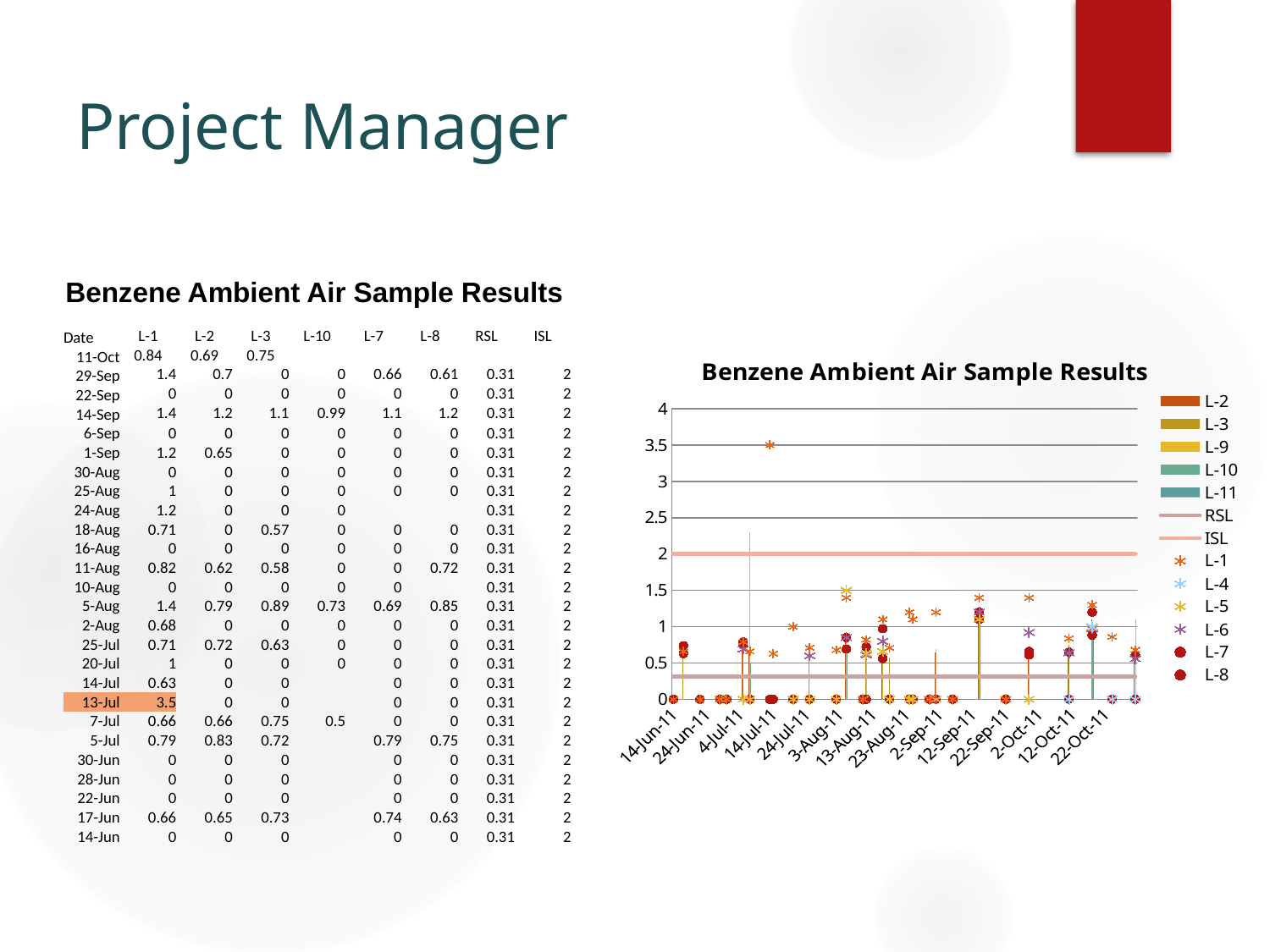
How many series does the chart's legend list? 13 What is the first date label shown on the chart's horizontal axis? 14-Jun-11 Is the highest L-1 point on the chart greater or less than 3? greater What is the title of the chart on the right side of the slide? Benzene Ambient Air Sample Results What is the highest value shown on the chart's vertical axis? 4 At what value does the ISL line sit on the chart? 2 Which is higher on the chart, the ISL line or the RSL line? ISL Which series has the single highest plotted point on the chart? L-1 What is the last date label shown on the chart's horizontal axis? 22-Oct-11 Is the RSL line on the chart greater or less than 0.5? less What value does the highest plotted point for L-1 reach on the chart? 3.5 Is the ISL line on the chart greater or less than 1? greater